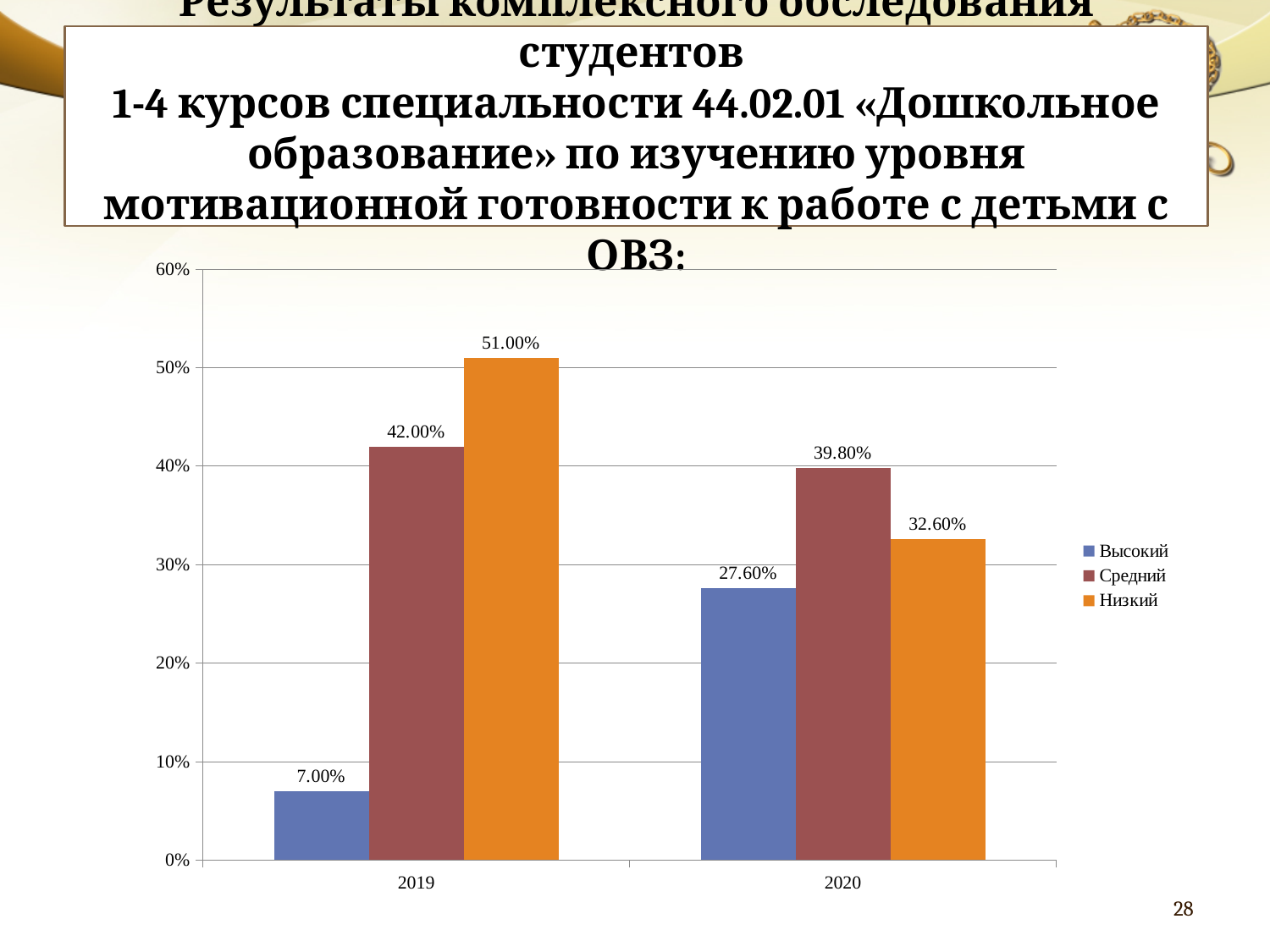
What is the value for Средний in 2020? 39.80% What is the difference between the Низкий values for 2019 and 2020? 18.40% Which series has the lowest value in 2020? Высокий What is the value for Высокий in 2019? 7.00% Is the value for Высокий in 2020 greater or less than 20%? greater How many categories are shown on the x axis? 2 Does the value for Высокий rise or fall from 2019 to 2020? rise What is the value for Низкий in 2020? 32.60% Which series has the highest value in 2019? Низкий How many series does the legend list? 3 What kind of chart is shown on the slide? bar chart Which is larger: Средний in 2019 or Средний in 2020? Средний in 2019